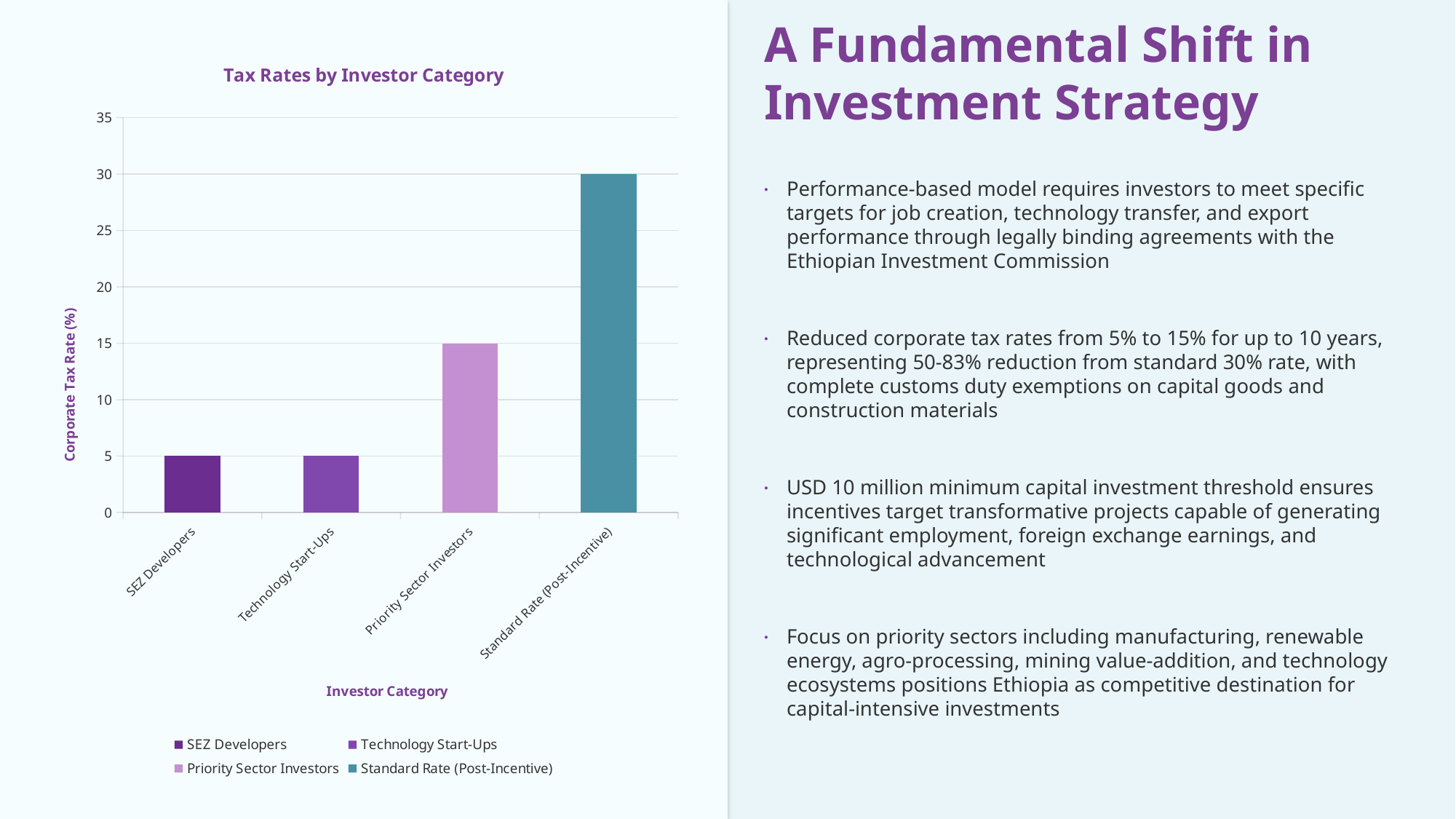
Is the value for Standard Rate (Post-Incentive) greater or less than 25? greater What is the corporate tax rate for Standard Rate (Post-Incentive)? 30 How many investor categories are shown on the x axis? 4 What is the difference between the Standard Rate (Post-Incentive) and the rate for Technology Start-Ups? 25 What is the corporate tax rate for SEZ Developers? 5 What kind of chart is shown on the slide? bar chart What is the title of the chart's vertical axis? Corporate Tax Rate (%) What is the difference between the Standard Rate (Post-Incentive) and the rate for Priority Sector Investors? 15 Which has a higher corporate tax rate, Priority Sector Investors or Technology Start-Ups? Priority Sector Investors What is the corporate tax rate for Priority Sector Investors? 15 How many entries does the legend list? 4 Which investor category has the highest corporate tax rate? Standard Rate (Post-Incentive)